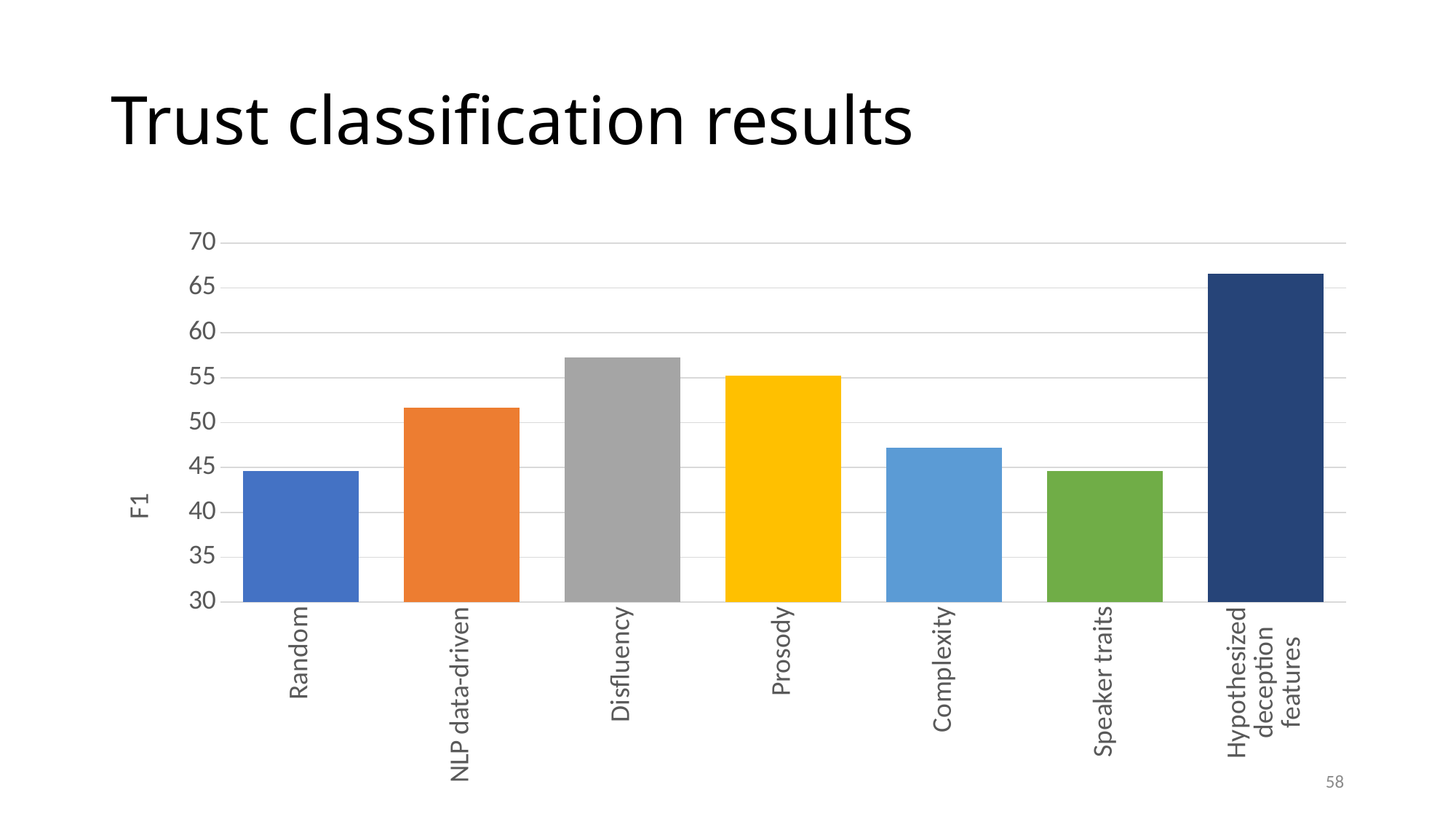
What is the title of the slide? Trust classification results What kind of chart is shown on the slide? bar chart What is the label on the vertical axis of the chart? F1 Is the value for Complexity greater or less than 50? less Which is larger, the value for Disfluency or the value for Prosody? Disfluency Is the value for Disfluency greater or less than 55? greater Which category has the highest F1 value? Hypothesized deception features Is the value for NLP data-driven greater or less than 50? greater How many categories are plotted on the chart? 7 Which is larger, the value for Complexity or the value for NLP data-driven? NLP data-driven